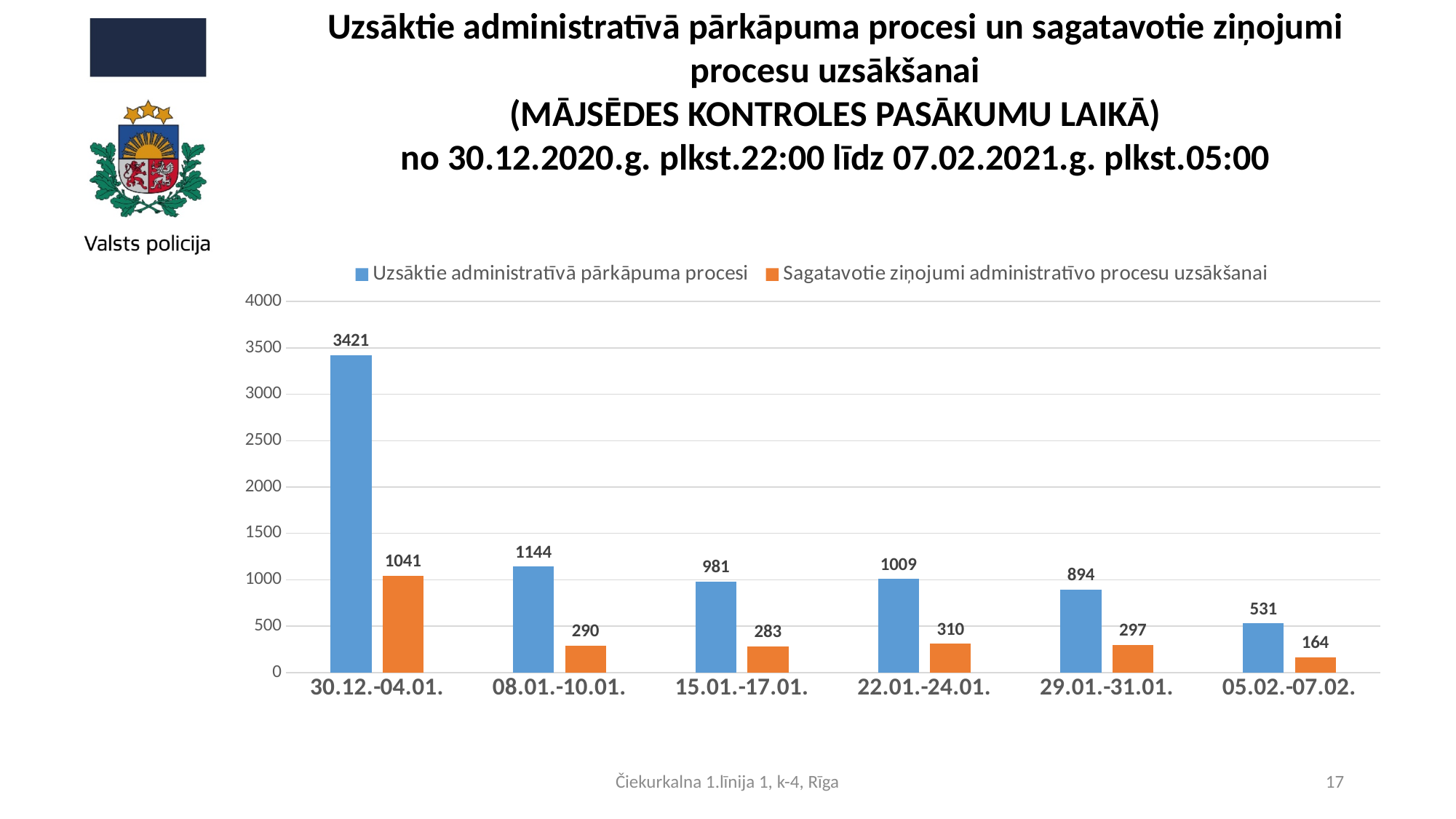
Which colour represents 'Sagatavotie ziņojumi administratīvo procesu uzsākšanai' in the chart? Orange Which period has the highest value for 'Uzsāktie administratīvā pārkāpuma procesi'? 30.12.-04.01. Which is larger: 'Uzsāktie administratīvā pārkāpuma procesi' for 15.01.-17.01. or for 22.01.-24.01.? 22.01.-24.01. What kind of chart is shown on the slide? Bar chart Which period has the lowest value for 'Sagatavotie ziņojumi administratīvo procesu uzsākšanai'? 05.02.-07.02. How many series does the legend list? 2 Is the value for 'Uzsāktie administratīvā pārkāpuma procesi' for 29.01.-31.01. greater or less than 1000? less What is the value of 'Sagatavotie ziņojumi administratīvo procesu uzsākšanai' for 22.01.-24.01.? 310 How many periods are shown on the x axis? 6 What is the value of 'Uzsāktie administratīvā pārkāpuma procesi' for 05.02.-07.02.? 531 What is the difference between 'Uzsāktie administratīvā pārkāpuma procesi' and 'Sagatavotie ziņojumi administratīvo procesu uzsākšanai' for 08.01.-10.01.? 854 What is the value of 'Uzsāktie administratīvā pārkāpuma procesi' for 30.12.-04.01.? 3421